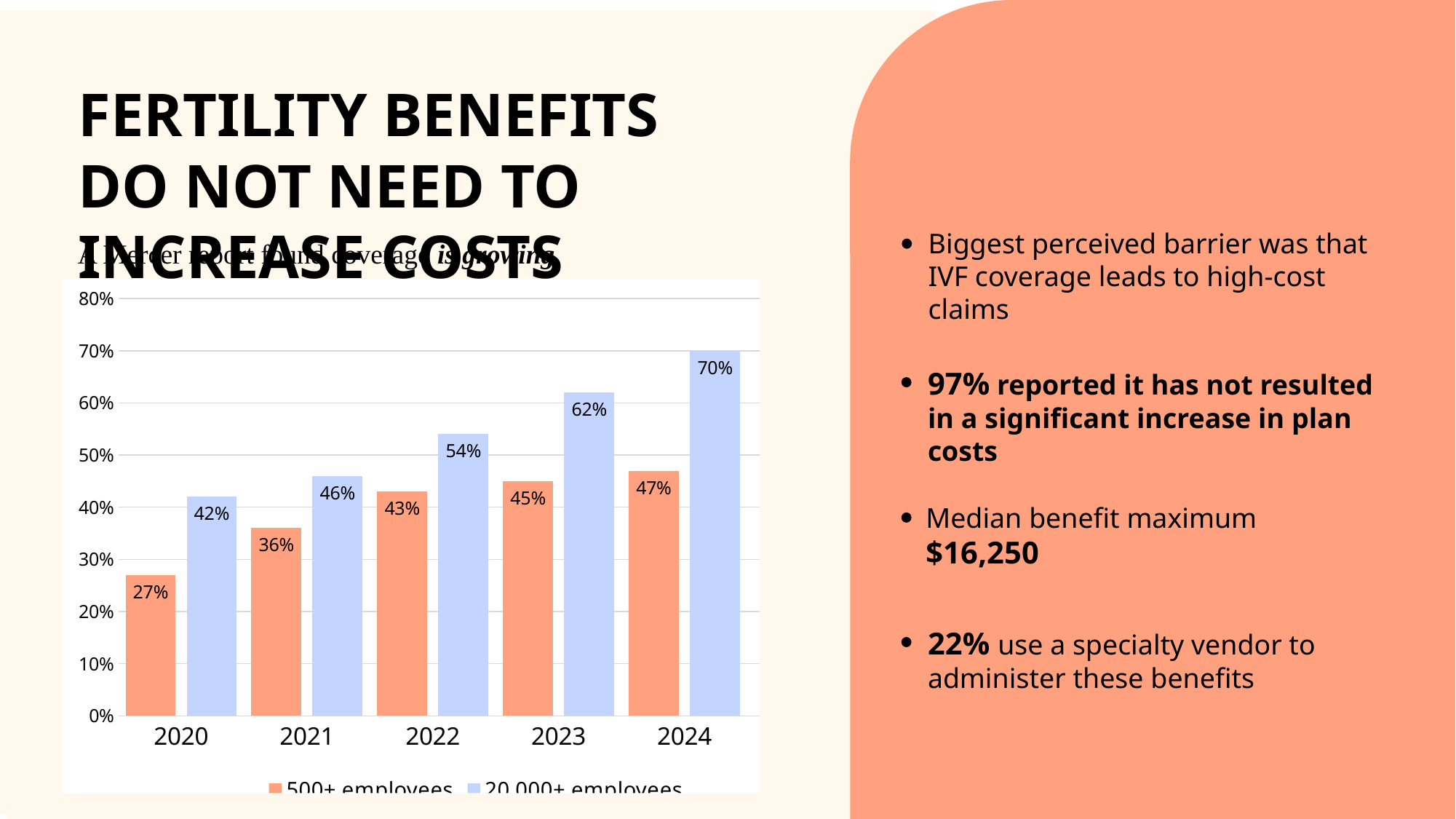
In which year is the value for 500+ employees lowest? 2020 What is the value for 500+ employees in 2023? 45% Which is larger in 2021: the value for 500+ employees or for 20,000+ employees? 20,000+ employees What kind of chart is shown on the slide? Bar chart Do the values for 20,000+ employees rise or fall from 2020 to 2024? Rise What is the value for 20,000+ employees in 2022? 54% How many years are shown on the x axis? 5 What is the difference between the 20,000+ employees and 500+ employees values in 2024? 23% How many series does the legend list? 2 What is the value for 500+ employees in 2020? 27% In which year is the value for 20,000+ employees highest? 2024 What is the value for 20,000+ employees in 2024? 70%